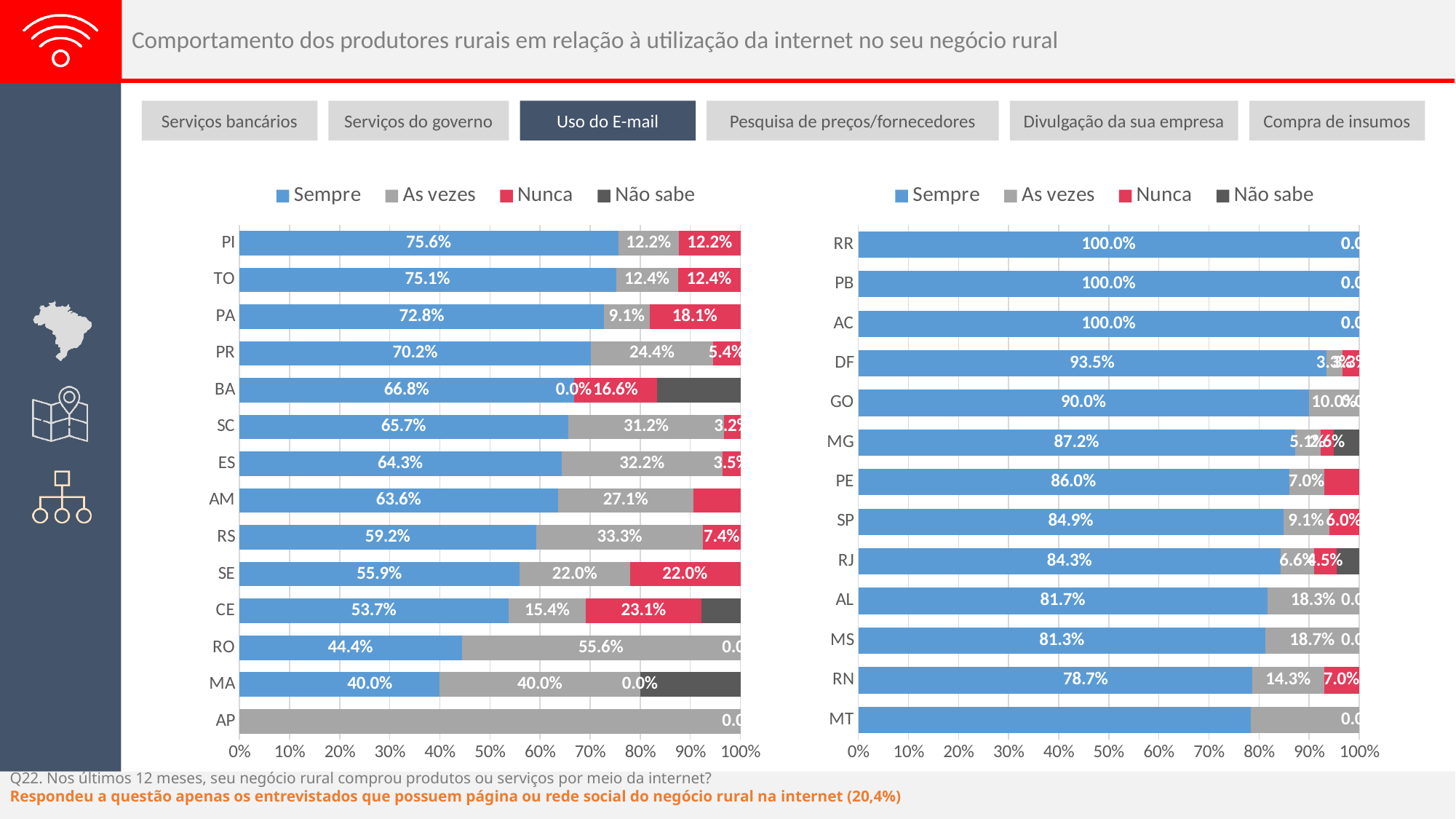
In the left chart, is the 'Sempre' value for MA greater or less than 50%? less In the left chart, what is the 'As vezes' value for RO? 55.6% How many states are shown in the left chart? 14 In the right chart, what is the 'Nunca' value for RN? 7.0% In the left chart, which state has the highest 'Sempre' value? PI In the left chart, what is the 'Sempre' value for PI? 75.6% In the right chart, what is the 'As vezes' value for MS? 18.7% In the right chart, what is the 'Sempre' value for DF? 93.5% In the left chart, what is the difference between the 'Sempre' values for PR and RS? 11.0% In the left chart, which has a larger 'Sempre' value, SE or CE? SE In the left chart, what is the 'Nunca' value for CE? 23.1% How many series does the legend of the right chart list? 4